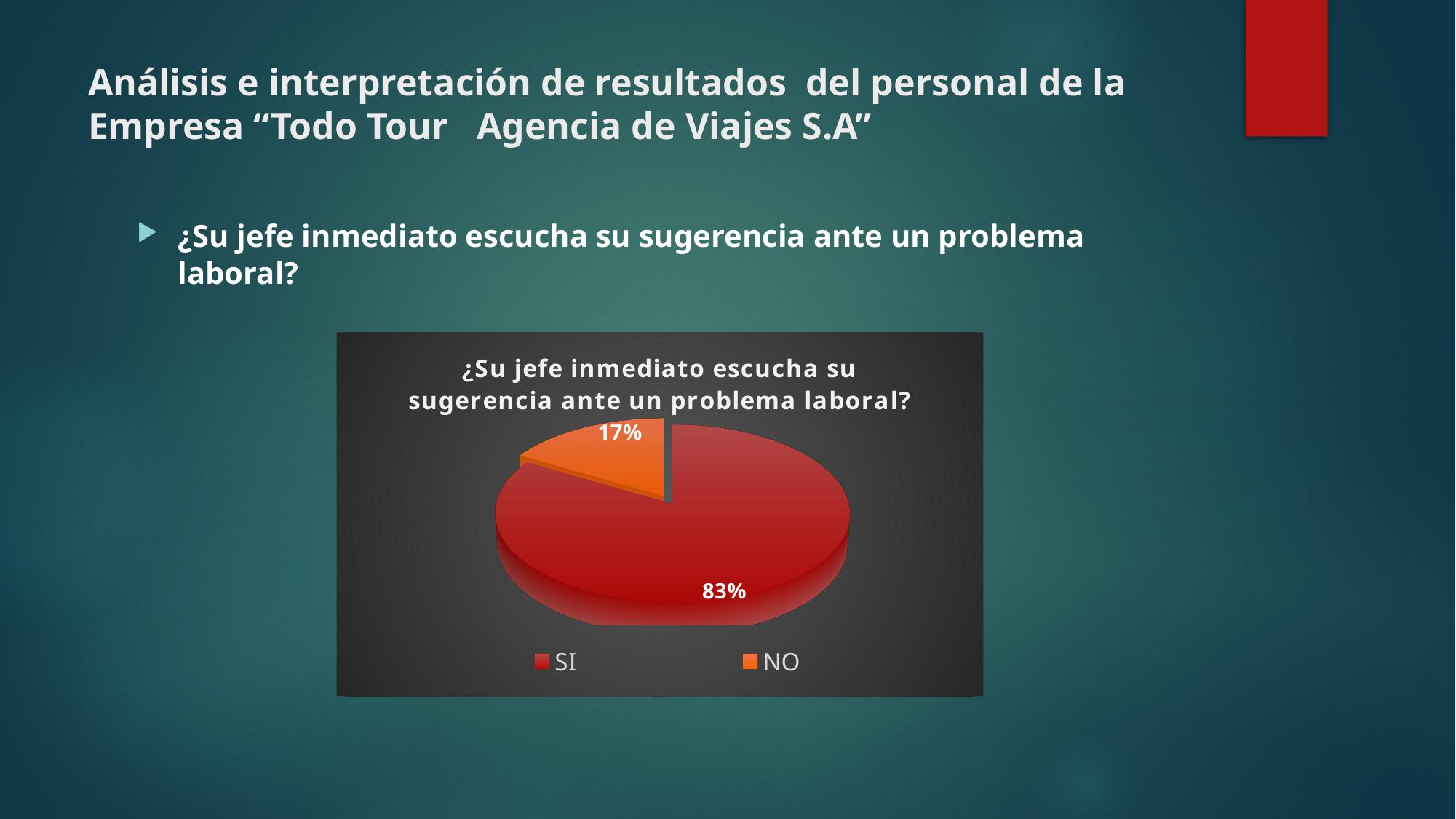
What percentage of respondents answered NO? 17% How many entries does the legend list? 2 What is the difference in percentage points between the SI and NO responses? 66 Which response has the smallest share of the pie? NO Which response has the largest share of the pie? SI How many slices does the pie chart have? 2 What is the title of the chart? ¿Su jefe inmediato escucha su sugerencia ante un problema laboral? What colour is the SI slice in the pie chart? Red What kind of chart is shown on the slide? Pie chart Which is larger, the share for SI or the share for NO? SI What share of the pie does the NO slice represent? 17% What percentage of respondents answered SI? 83%